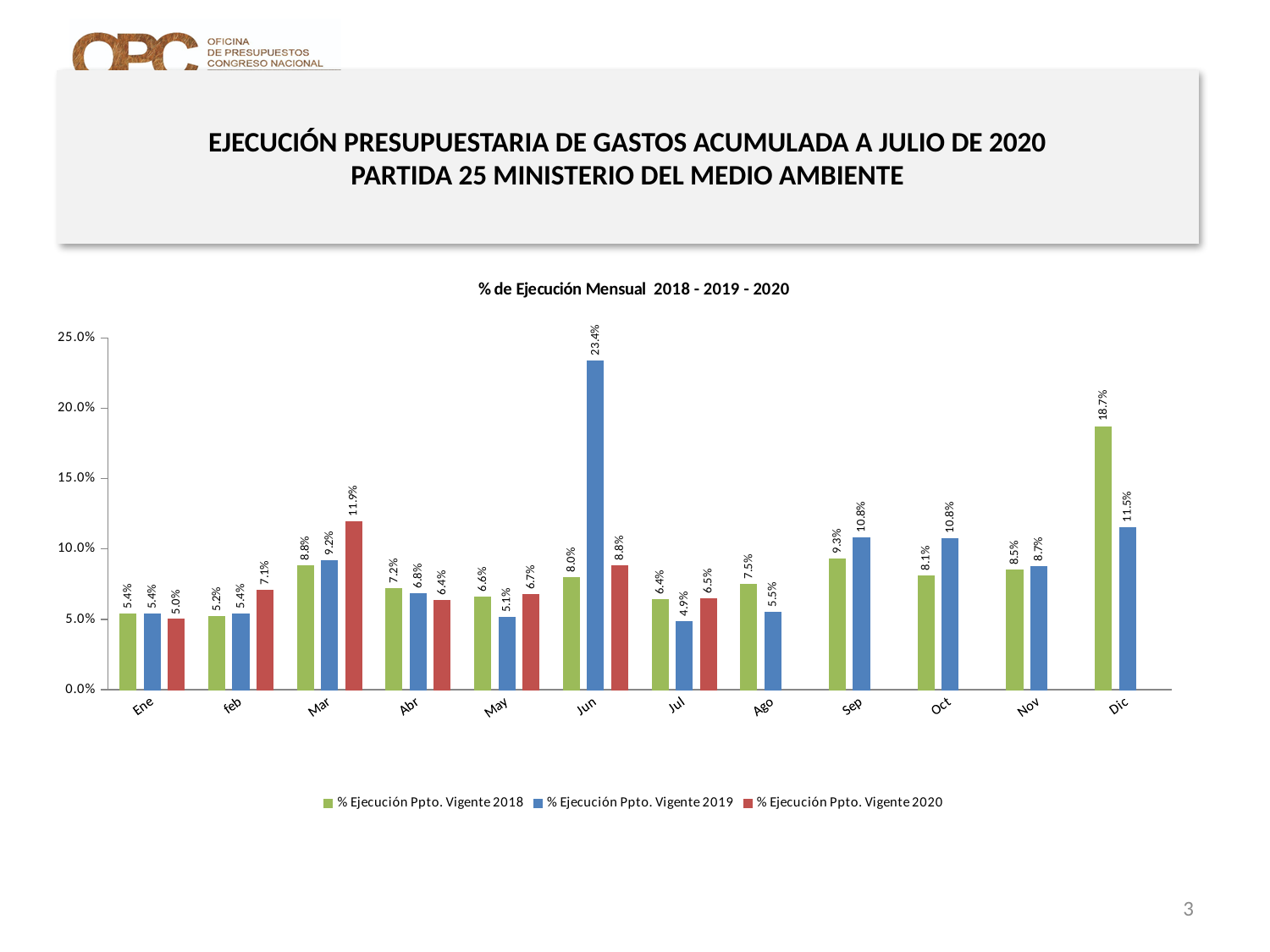
How many series does the legend list? 3 Is the value for Dic in the 2019 series greater or less than 10.0%? greater What is the difference between the 2019 and 2018 values for Jun? 15.4% Which is larger for Sep: the 2018 value or the 2019 value? 2019 Which month has the lowest value in the % Ejecución Ppto. Vigente 2019 series? Jul What kind of chart is shown on the slide? Bar chart What is the value for Dic in the % Ejecución Ppto. Vigente 2018 series? 18.7% What is the value for Mar in the % Ejecución Ppto. Vigente 2020 series? 11.9% What is the value for Jun in the % Ejecución Ppto. Vigente 2019 series? 23.4% Which month has the highest value in the % Ejecución Ppto. Vigente 2018 series? Dic What is the title of the chart? % de Ejecución Mensual 2018 - 2019 - 2020 How many months are shown on the x axis? 12